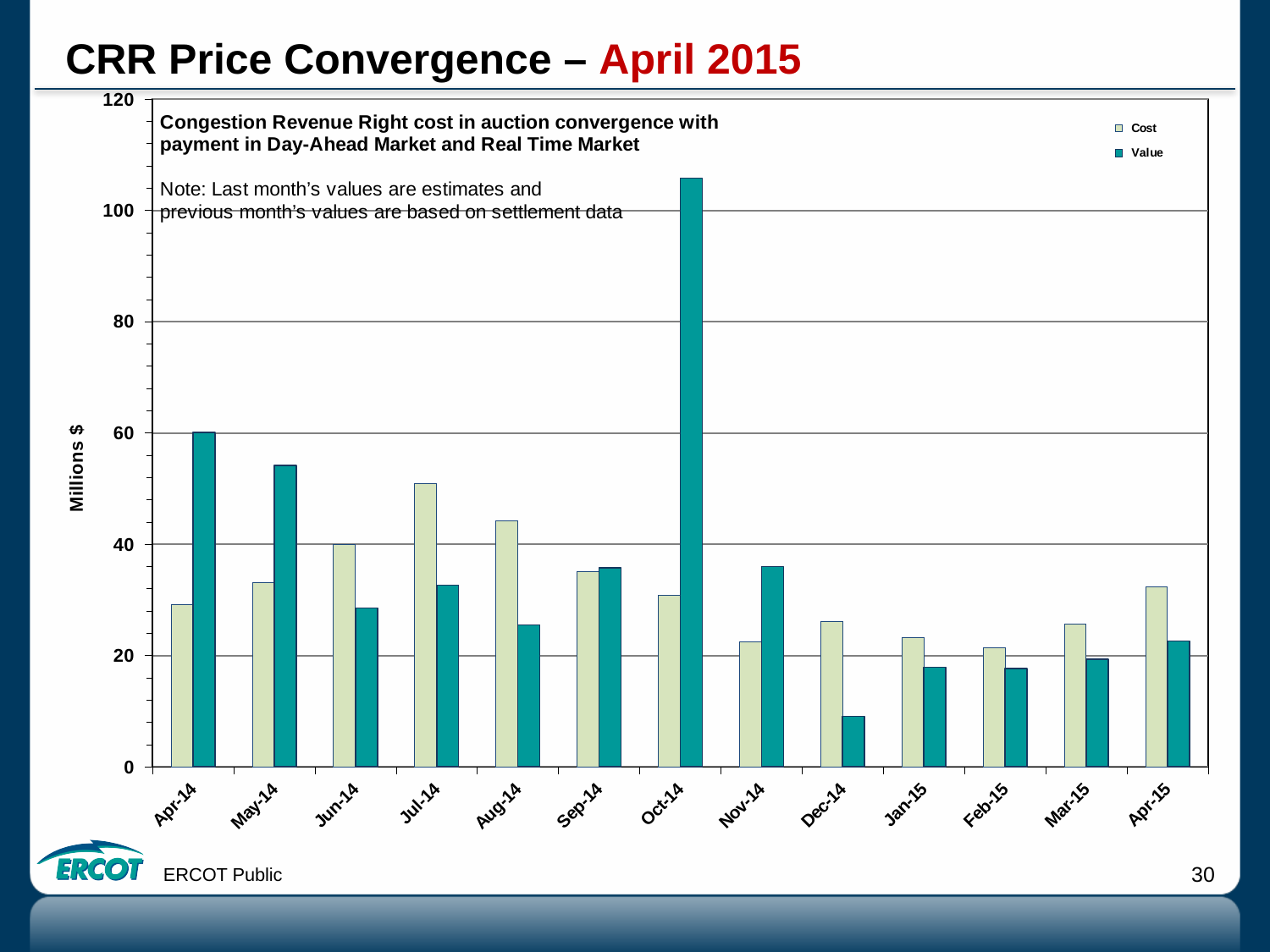
Is the Value for Oct-14 greater or less than 100? greater Which month has the highest Value bar? Oct-14 Which month has the lowest Value bar? Dec-14 For Jul-14, which is larger, Cost or Value? Cost Is the Value for Dec-14 greater or less than 20? less What is the label on the y axis? Millions $ For Apr-14, which is larger, Cost or Value? Value Which month has the highest Cost bar? Jul-14 What type of chart is shown on the slide? bar chart Is the Cost for Jul-14 greater or less than 40? greater How many months are shown on the x axis? 13 How many series does the legend list? 2